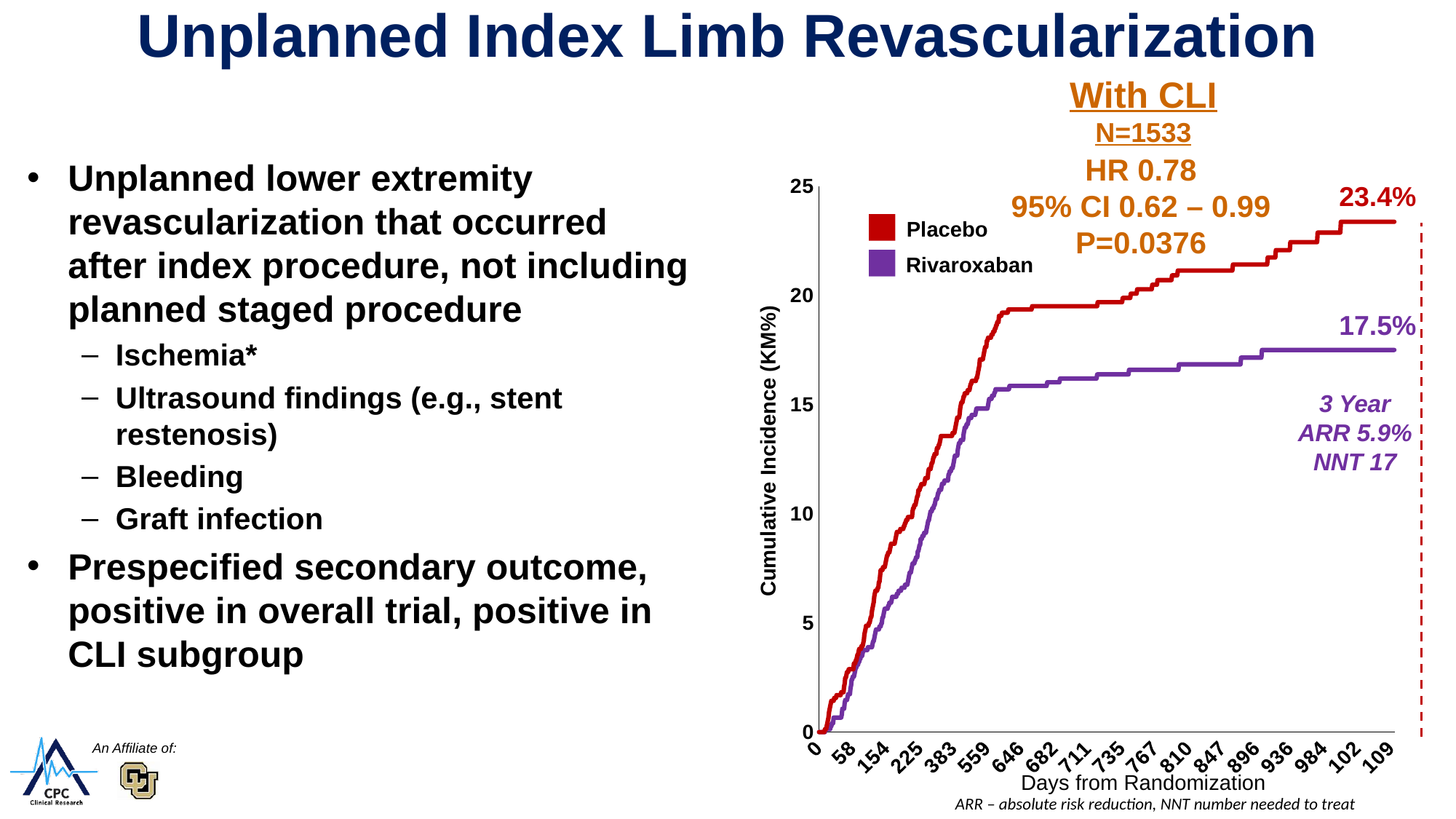
Is the final value for the Placebo curve greater or less than 20? greater What is the final cumulative incidence value labeled for the Rivaroxaban curve? 17.5% Which colour represents the Placebo series in the chart? Red How many series does the legend list? 2 What is the difference between the final labeled values for Placebo and Rivaroxaban? 5.9% What kind of chart is shown on the slide? Line chart Do the cumulative incidence curves rise or fall as days from randomization increase? Rise Which series has the higher final cumulative incidence, Placebo or Rivaroxaban? Placebo What is the final cumulative incidence value labeled for the Placebo curve? 23.4% What is the hazard ratio shown above the chart for the CLI subgroup? 0.78 What is the label of the y-axis? Cumulative Incidence (KM%) Is the final value for the Rivaroxaban curve greater or less than 20? less